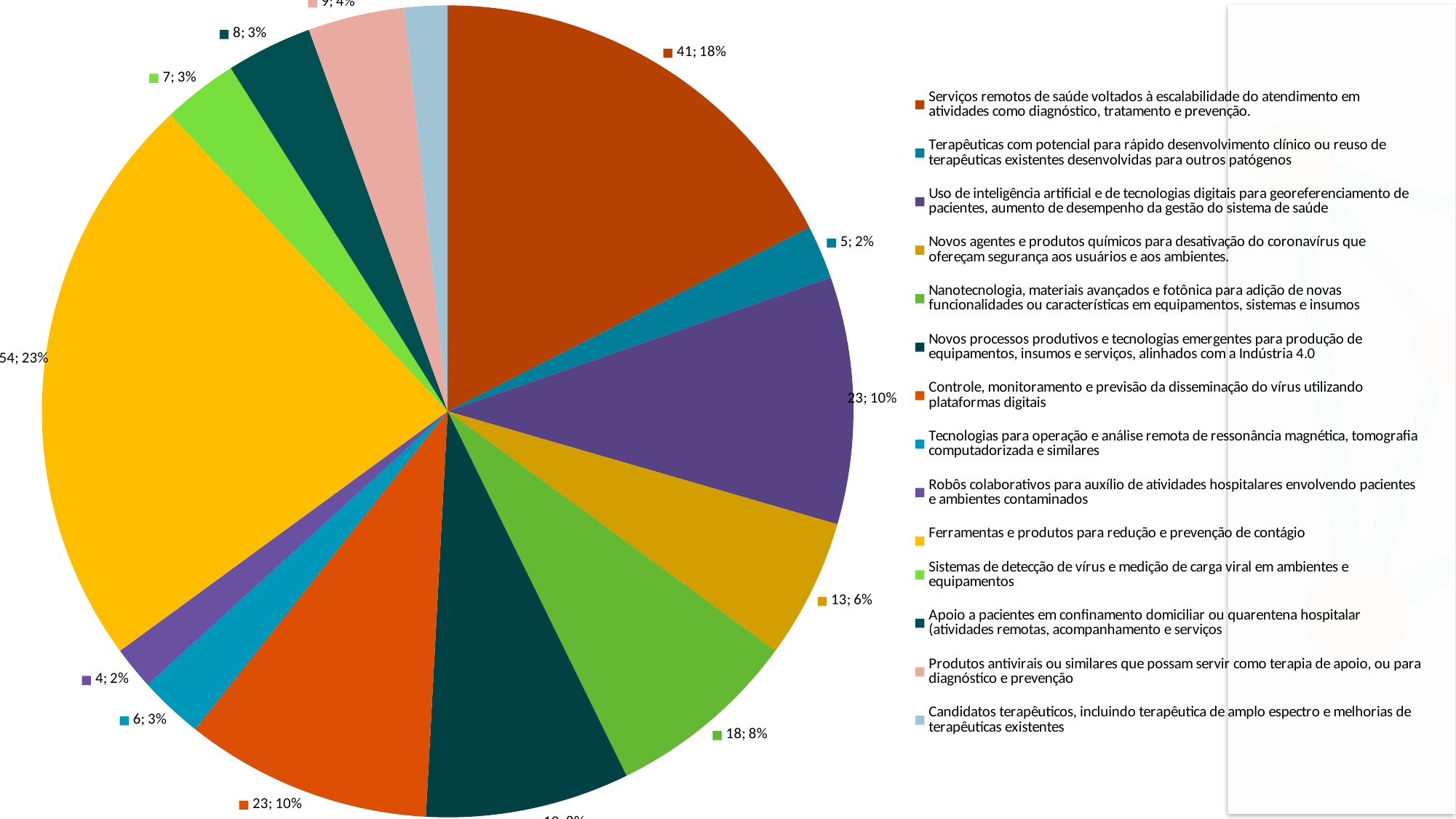
How many categories does the legend of the pie chart list? 14 What share of the pie does 'Uso de inteligência artificial e de tecnologias digitais para georeferenciamento de pacientes' represent? 10% Which category has the largest slice of the pie? Ferramentas e produtos para redução e prevenção de contágio Which has a larger value: 'Uso de inteligência artificial e de tecnologias digitais' or 'Novos agentes e produtos químicos'? Uso de inteligência artificial e de tecnologias digitais What is the difference between the value for 'Ferramentas e produtos para redução e prevenção de contágio' (54) and 'Serviços remotos de saúde' (41)? 13 What colour is the largest slice of the pie? yellow What value and percentage are shown for 'Robôs colaborativos para auxílio de atividades hospitalares'? 4; 2% What type of chart is shown on the slide? pie chart What value and percentage are shown for the slice 'Serviços remotos de saúde voltados à escalabilidade do atendimento em atividades como diagnóstico, tratamento e prevenção'? 41; 18% What value and percentage are shown for the slice 'Ferramentas e produtos para redução e prevenção de contágio'? 54; 23% What value and percentage are shown for 'Novos agentes e produtos químicos para desativação do coronavírus'? 13; 6% What value and percentage are shown for 'Nanotecnologia, materiais avançados e fotônica'? 18; 8%